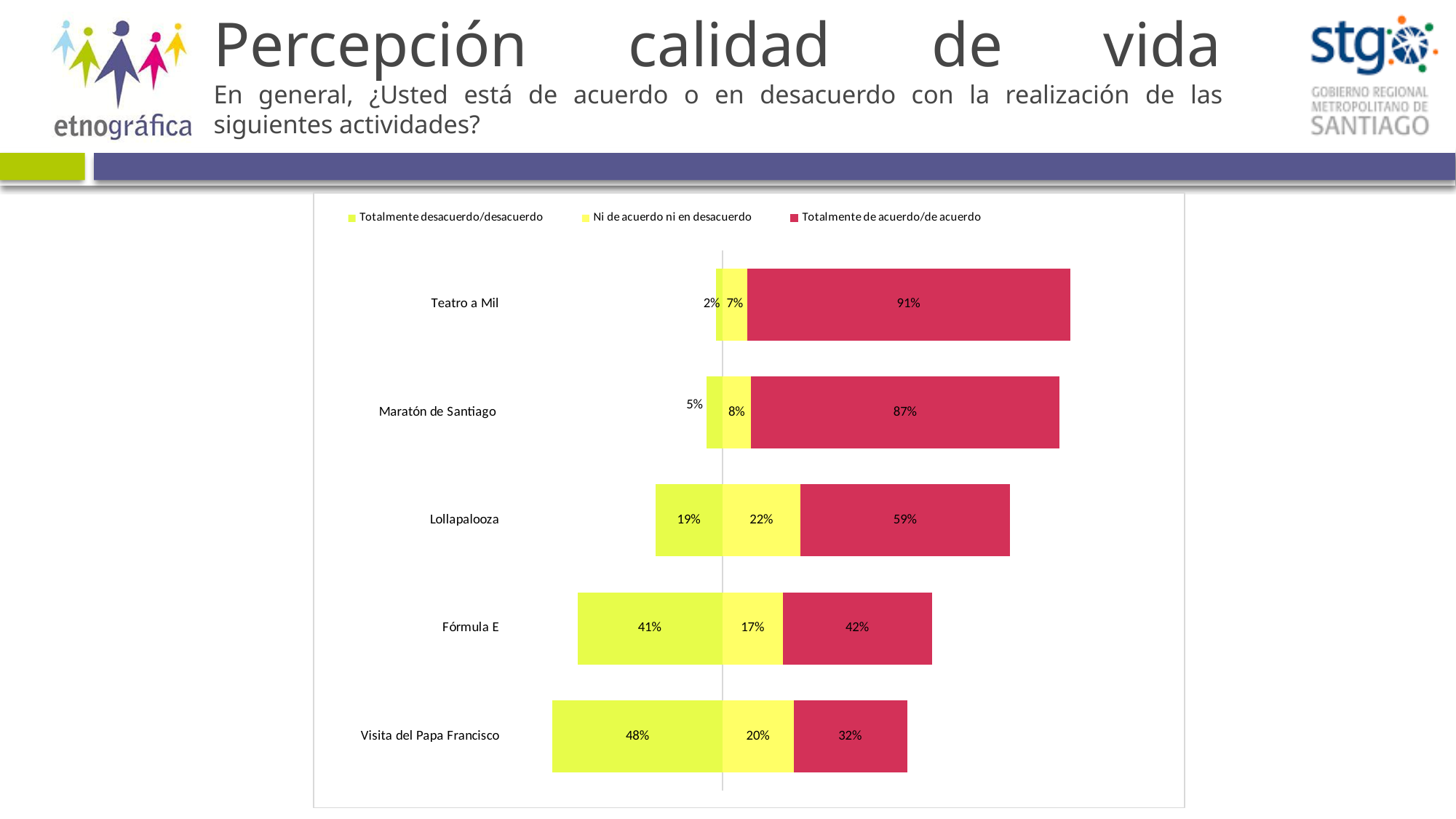
What is the total of the three segments for the Fórmula E bar? 100% What is the 'Ni de acuerdo ni en desacuerdo' value for Lollapalooza? 22% What percentage of respondents are 'Totalmente de acuerdo/de acuerdo' with Teatro a Mil? 91% What is the 'Totalmente desacuerdo/desacuerdo' value for Visita del Papa Francisco? 48% How many series does the legend list? 3 What kind of chart is shown on the slide? Stacked bar chart How many activities are shown in the chart? 5 Which colour represents 'Totalmente de acuerdo/de acuerdo' in the chart? Red What is the difference between the 'Totalmente de acuerdo/de acuerdo' values for Maratón de Santiago and Lollapalooza? 28% Which activity has the highest 'Totalmente de acuerdo/de acuerdo' percentage? Teatro a Mil Which activity has the lowest 'Totalmente de acuerdo/de acuerdo' percentage? Visita del Papa Francisco Which is larger for Fórmula E: the 'Totalmente desacuerdo/desacuerdo' value or the 'Totalmente de acuerdo/de acuerdo' value? Totalmente de acuerdo/de acuerdo